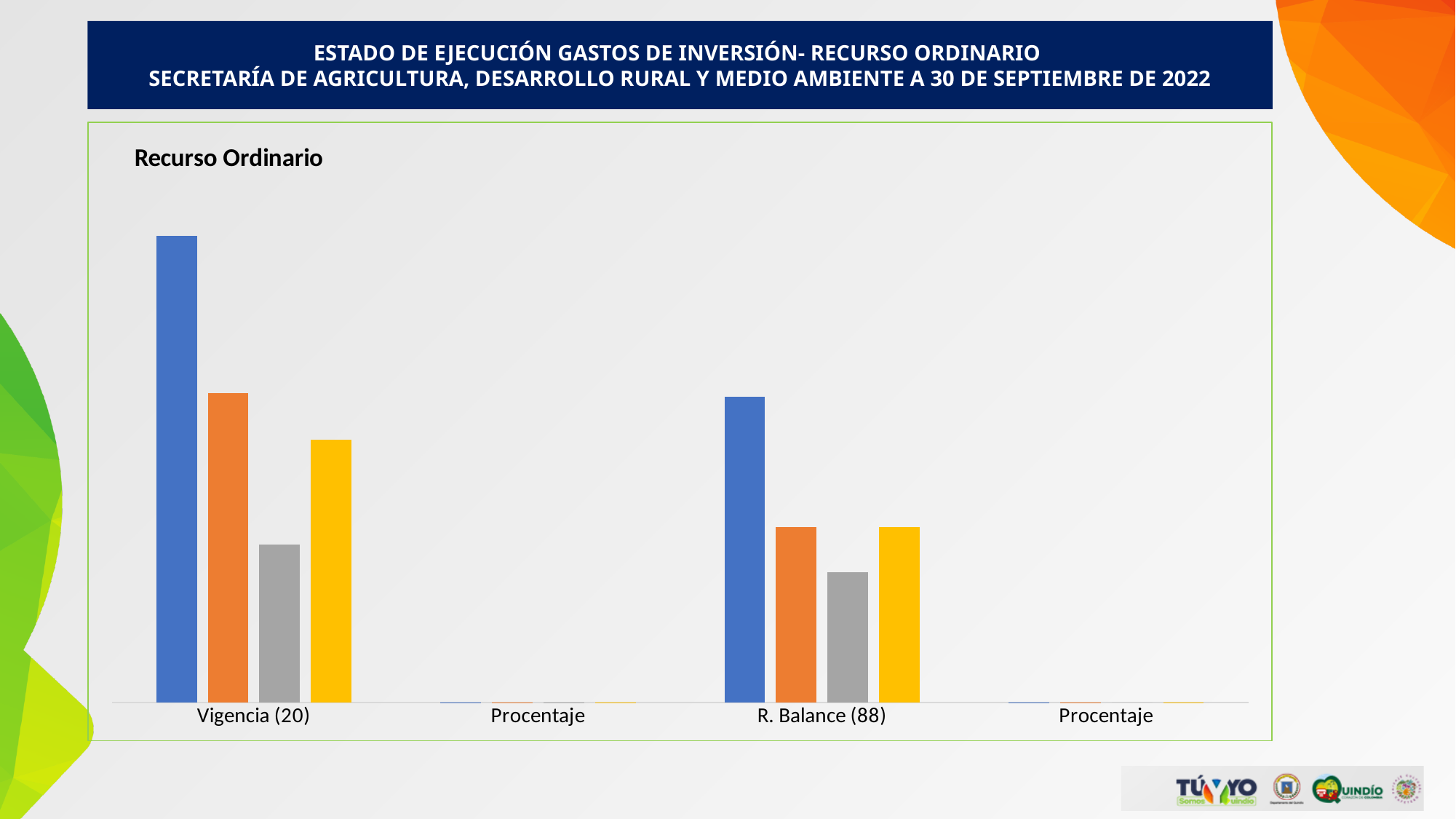
How many categories are shown on the x axis of the chart? 4 Within the R. Balance (88) category, which coloured bar is the tallest? blue What is the title of the chart? Recurso Ordinario What kind of chart is shown on the slide? bar chart Which category has the tallest bar in the chart? Vigencia (20) Within the Vigencia (20) category, is the orange bar taller or shorter than the yellow bar? taller Is the gray bar taller for Vigencia (20) or for R. Balance (88)? Vigencia (20) Within the Vigencia (20) category, which coloured bar is the shortest? gray How many coloured bars are shown for the Vigencia (20) category? 4 Is the orange bar taller for Vigencia (20) or for R. Balance (88)? Vigencia (20) Which x-axis label appears twice in the chart? Procentaje